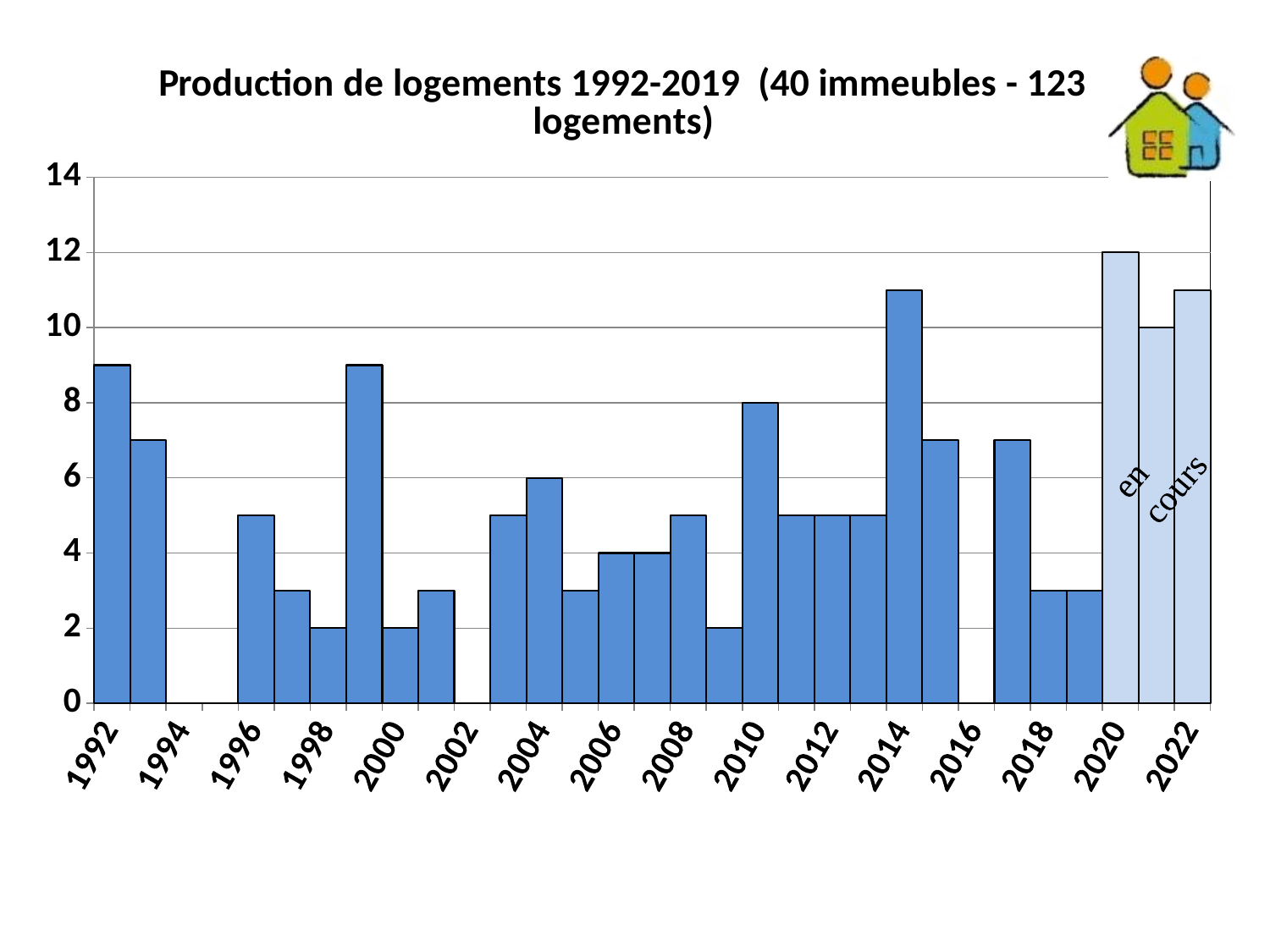
What is the value for 2004? 6 What is the difference between the values for 2020 and 2021? 2 Is the value for 2014 greater or less than 10? greater What label is written across the light-blue bars at the right of the chart? en cours Is the value for 1992 greater or less than 8? greater Which is larger, the value for 2010 or the value for 2004? 2010 What is the value for 1998? 2 What is the value for 2020? 12 Which year has the highest bar? 2020 What kind of chart is shown on the slide? bar chart What is the title of the chart? Production de logements 1992-2019 (40 immeubles - 123 logements) What is the value for 2010? 8